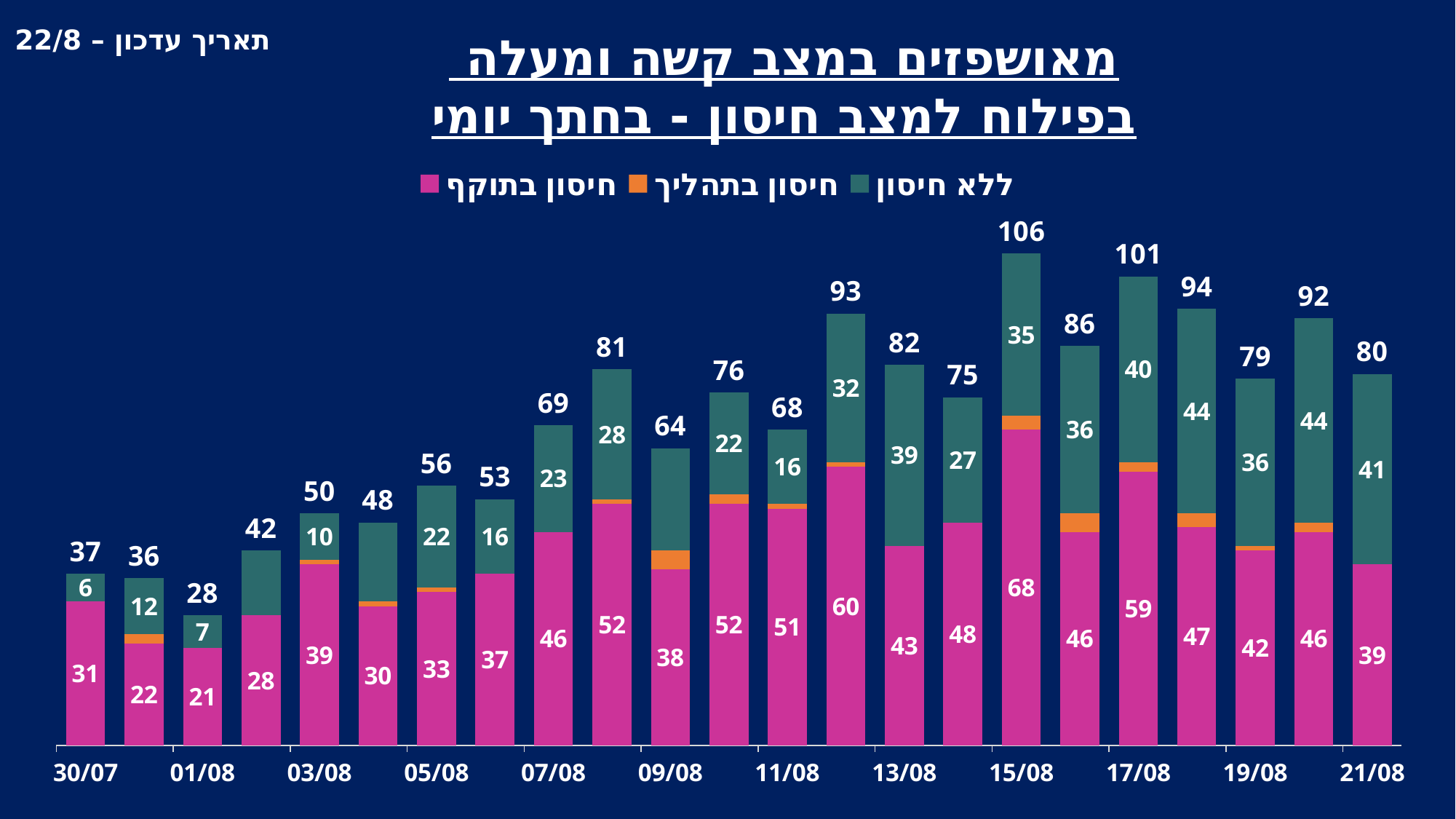
On which date is the total number of hospitalized patients lowest? 01/08 What is the value of the ללא חיסון (unvaccinated) segment on 21/08? 41 How many bars (days) are plotted in the chart? 23 What is the total value of the bar for 17/08? 101 On which date is the total number of hospitalized patients highest? 15/08 Which date has a larger total, 07/08 or 09/08? 07/08 How many series does the legend list? 3 Do the bar totals generally rise or fall from 30/07 to 15/08? Rise What kind of chart is shown on the slide? Stacked bar chart On 13/08, which segment is larger: ללא חיסון or חיסון בתוקף? חיסון בתוקף What is the difference between the total for 15/08 and the total for 13/08? 24 What is the value of the חיסון בתוקף (valid vaccination) segment on 15/08? 68